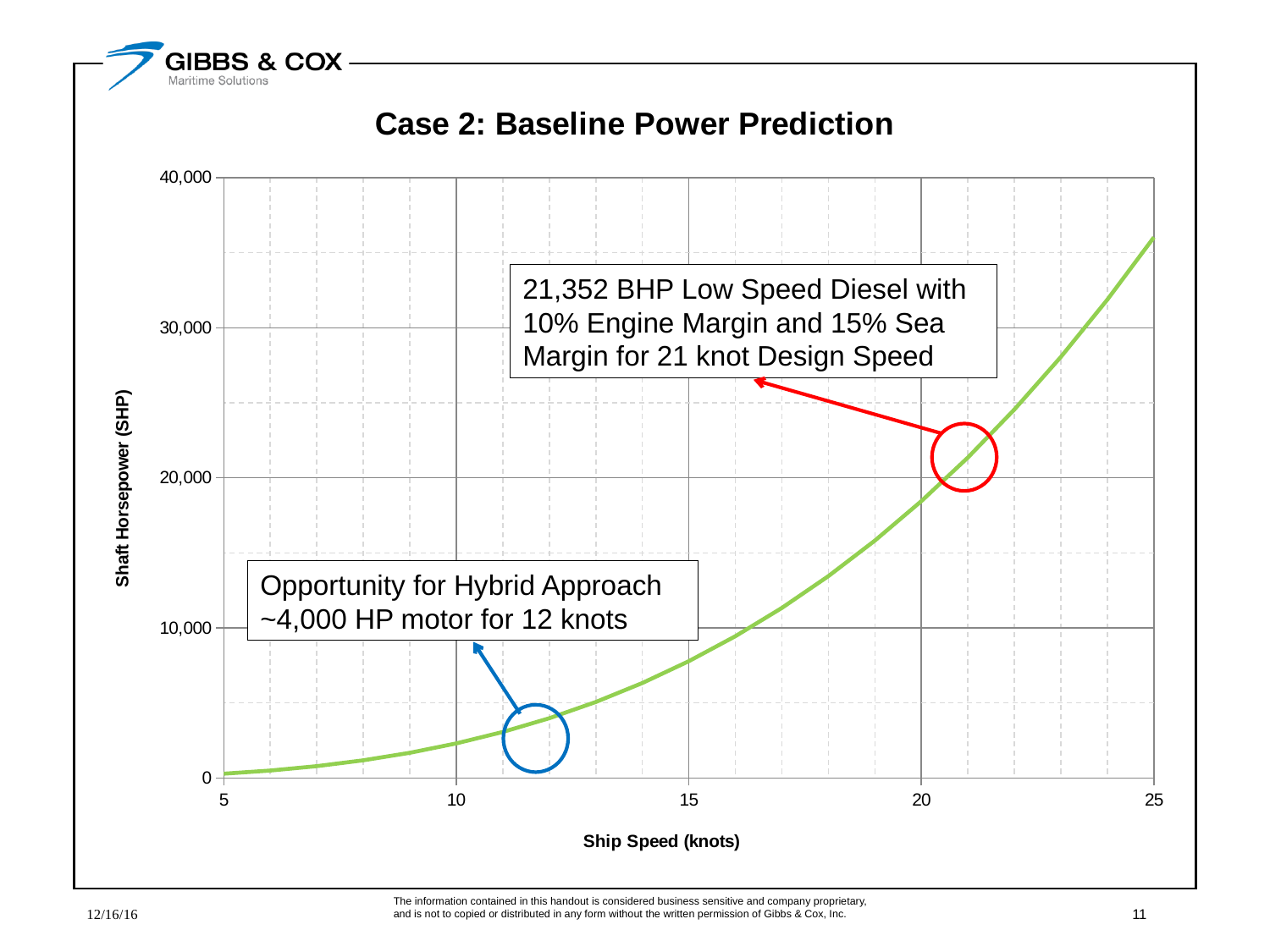
Which ship speed has the higher shaft horsepower, 15 knots or 20 knots? 20 knots Is the shaft horsepower at 20 knots greater or less than 20,000? less What kind of chart is shown on the slide? line chart What is the highest ship speed shown on the x axis? 25 What is the label of the y axis? Shaft Horsepower (SHP) Is the shaft horsepower at 25 knots greater or less than 30,000? greater Is the shaft horsepower at 10 knots greater or less than 10,000? less What is the title of the chart? Case 2: Baseline Power Prediction Does shaft horsepower rise or fall as ship speed increases along the x axis? rise